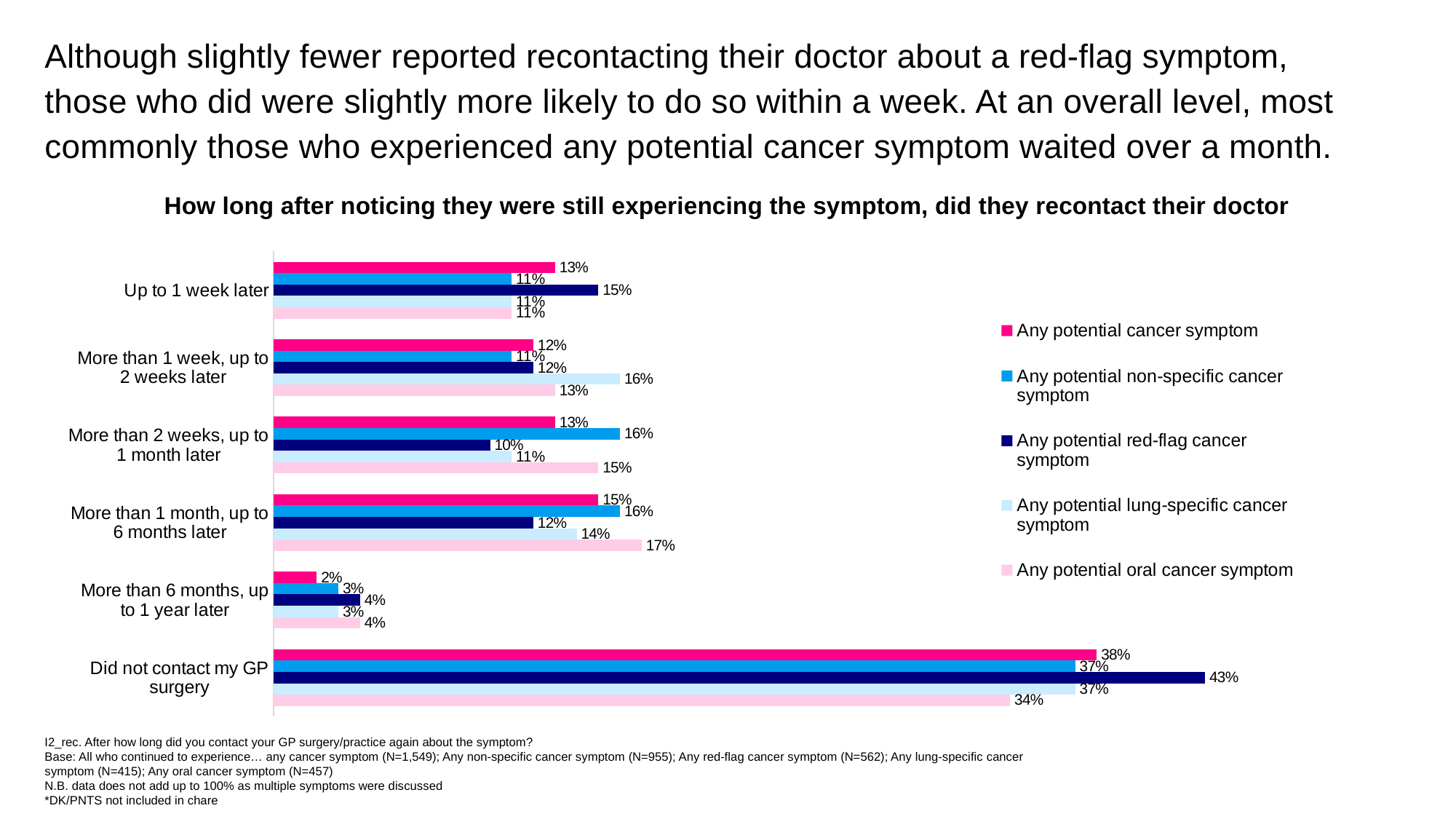
What is the value for 'Any potential cancer symptom' in the 'Up to 1 week later' category? 13% What is the value for 'Any potential oral cancer symptom' in the 'More than 1 month, up to 6 months later' category? 17% Which category has the lowest value for 'Any potential red-flag cancer symptom'? More than 6 months, up to 1 year later What kind of chart is shown on the slide? Bar chart How many series does the legend list? 5 Which category has the highest value for 'Any potential cancer symptom'? Did not contact my GP surgery What is the value for 'Any potential lung-specific cancer symptom' in the 'More than 1 week, up to 2 weeks later' category? 16% In the 'Up to 1 week later' category, which is larger: the value for 'Any potential red-flag cancer symptom' or 'Any potential non-specific cancer symptom'? Any potential red-flag cancer symptom What percentage of those with any potential red-flag cancer symptom did not contact their GP surgery? 43% How many time categories are shown on the chart? 6 What is the title of the chart? How long after noticing they were still experiencing the symptom, did they recontact their doctor What is the difference between the 'Any potential red-flag cancer symptom' and 'Any potential oral cancer symptom' values in the 'Did not contact my GP surgery' category? 9%